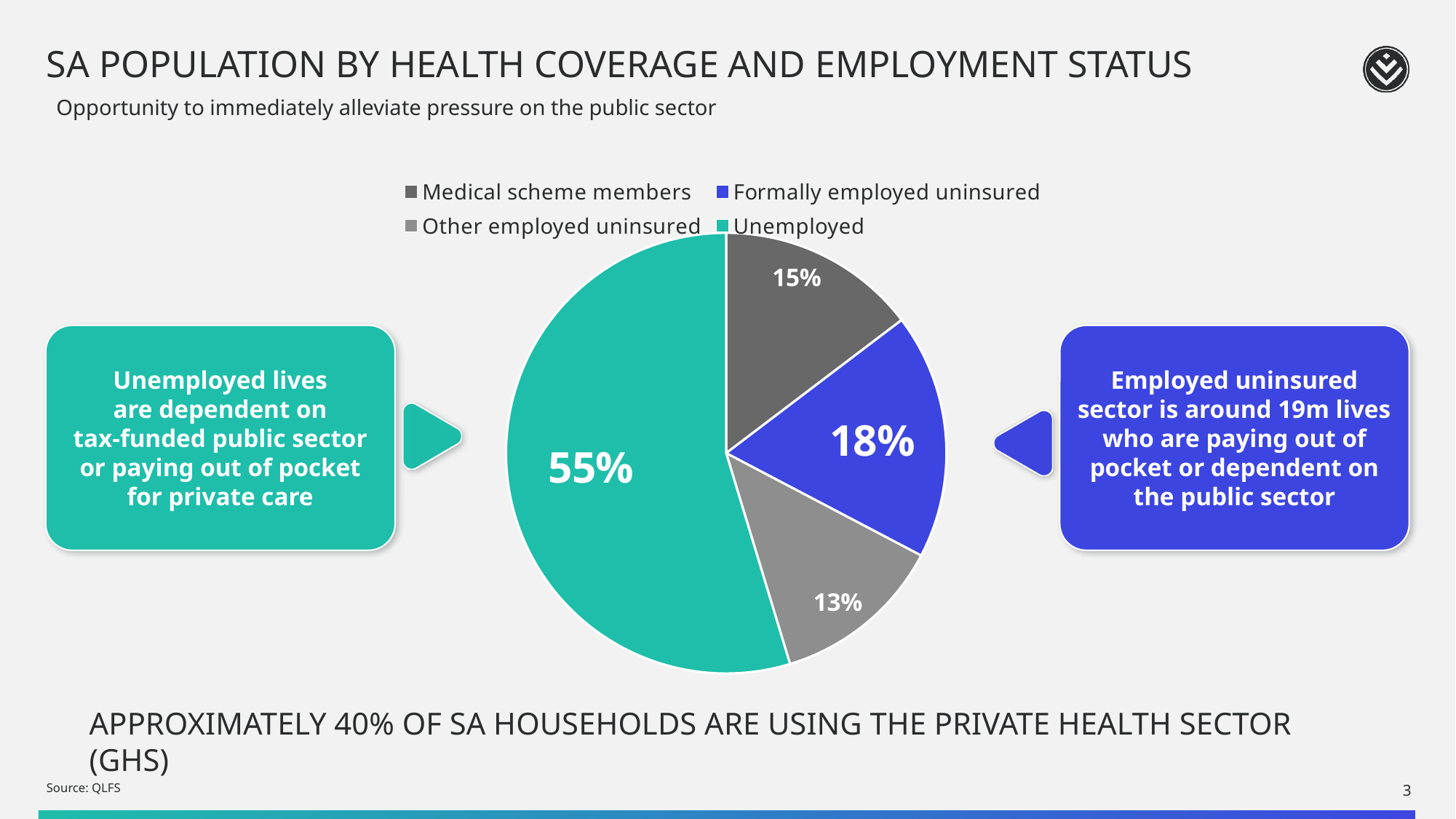
What is the difference in percentage points between Unemployed and Formally employed uninsured? 37 Which is larger, Medical scheme members or Formally employed uninsured? Formally employed uninsured Which category has the largest slice of the pie? Unemployed How many categories does the pie chart show? 4 What share of the pie is Formally employed uninsured? 18% What share of the pie is Medical scheme members? 15% What kind of chart is shown on the slide? Pie chart What is the combined share of Formally employed uninsured and Other employed uninsured? 31% Which category has the smallest slice of the pie? Other employed uninsured What colour is the Unemployed slice of the pie? Teal What share of the pie is Unemployed? 55% What share of the pie is Other employed uninsured? 13%